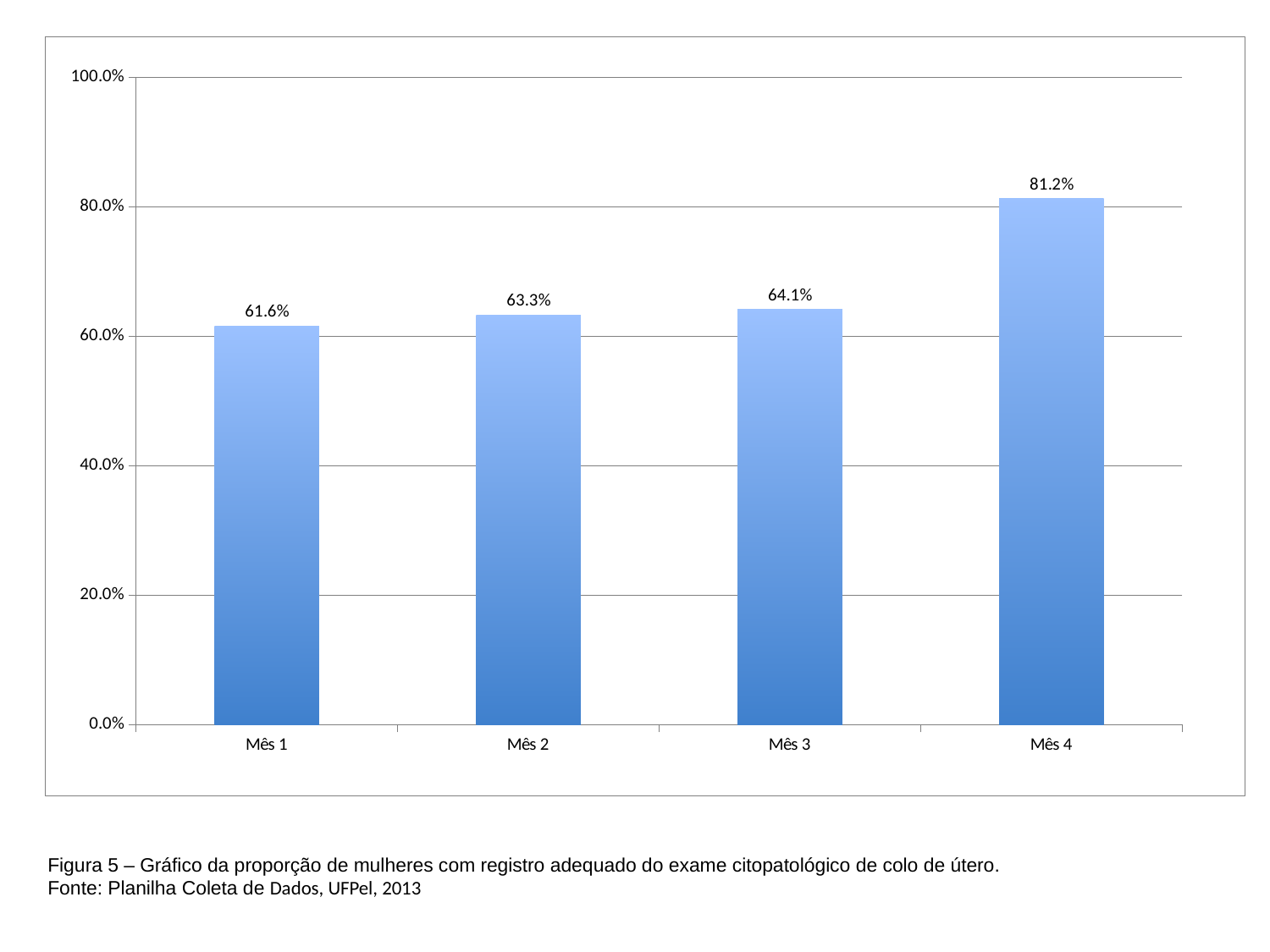
Which is larger, the value for Mês 4 or the value for Mês 2? Mês 4 What is the value for Mês 1? 61.6% What is the difference between the values for Mês 4 and Mês 3? 17.1% What kind of chart is shown on the slide? bar chart Which month has the lowest value? Mês 1 Which month has the highest value? Mês 4 What is the difference between the values for Mês 2 and Mês 1? 1.7% How many months are shown on the x axis? 4 What is the value for Mês 4? 81.2% What is the value for Mês 3? 64.1% Is the value for Mês 4 greater or less than 80.0%? greater Do the values rise or fall from Mês 1 to Mês 4? rise